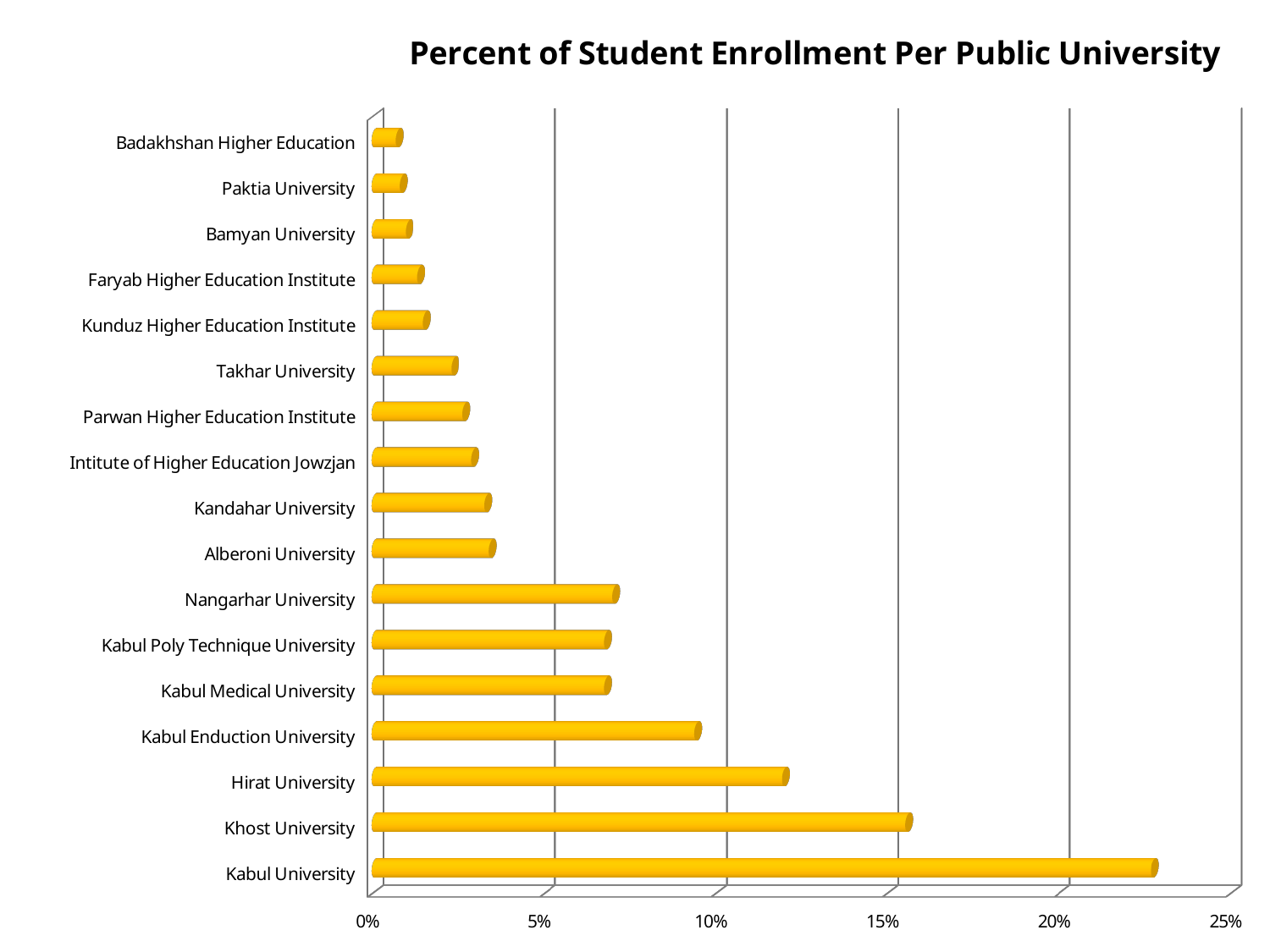
Which has a larger percent of student enrollment, Khost University or Hirat University? Khost University Is the value for Hirat University greater or less than 10%? greater Is the value for Khost University greater or less than 15%? greater Is the value for Kabul Enduction University greater or less than 10%? less Which has a larger percent of student enrollment, Kabul Enduction University or Nangarhar University? Kabul Enduction University Which university has the highest percent of student enrollment? Kabul University What is the title of the chart? Percent of Student Enrollment Per Public University How many universities or institutes are listed in the chart? 17 What type of chart is shown on the slide? bar chart